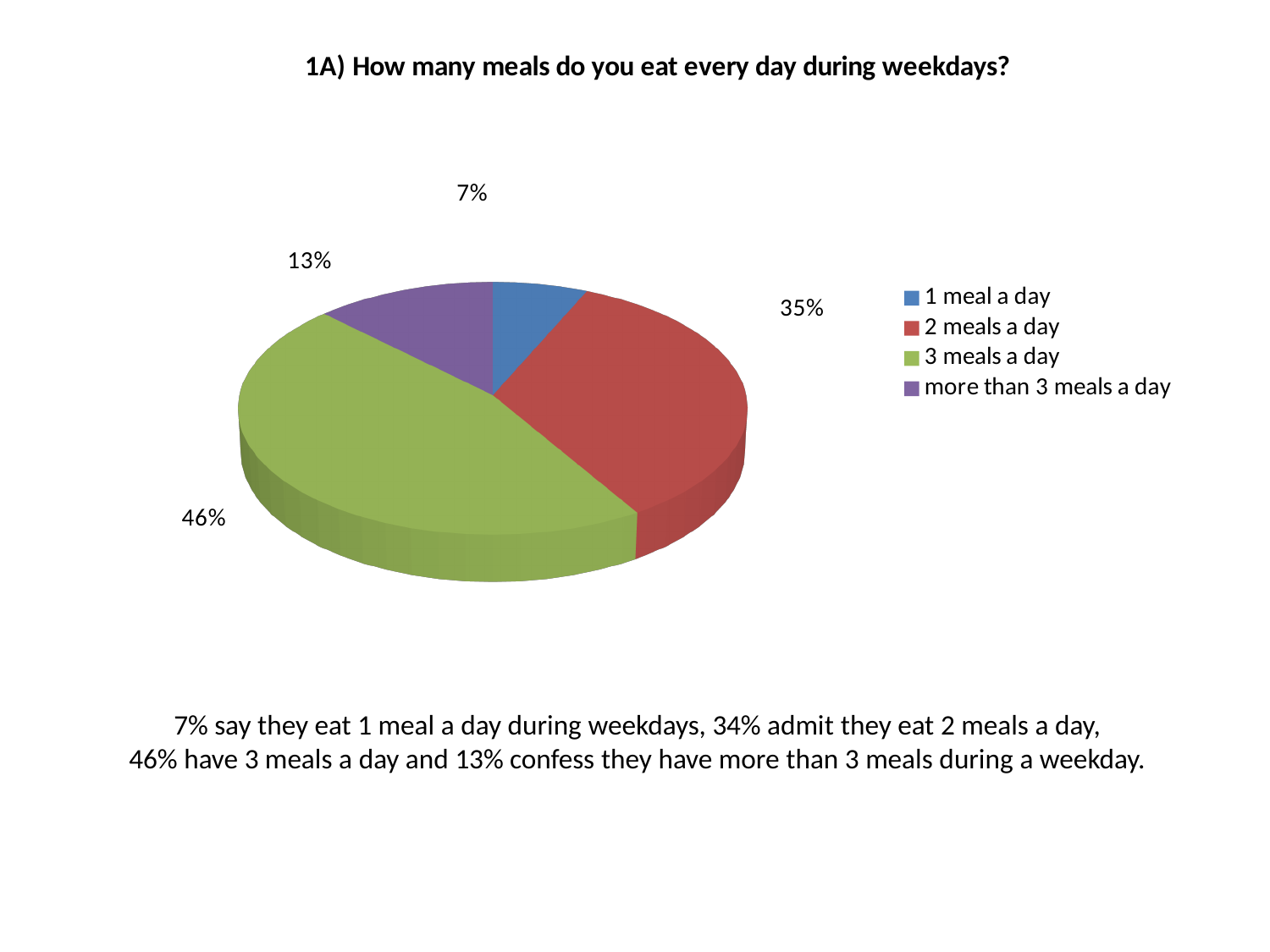
What percentage is shown for '2 meals a day'? 35% What percentage is shown for '1 meal a day'? 7% What colour is the slice for '3 meals a day'? Green What is the title of the chart? 1A) How many meals do you eat every day during weekdays? Which category has the largest slice of the pie? 3 meals a day How many categories does the pie chart show? 4 What share of the pie is labelled for '3 meals a day'? 46% What kind of chart is shown on the slide? Pie chart What percentage is shown for 'more than 3 meals a day'? 13% What is the difference in percentage points between '3 meals a day' and '2 meals a day'? 11 Which is larger, the slice for '2 meals a day' or the slice for 'more than 3 meals a day'? 2 meals a day Which category has the smallest slice of the pie? 1 meal a day